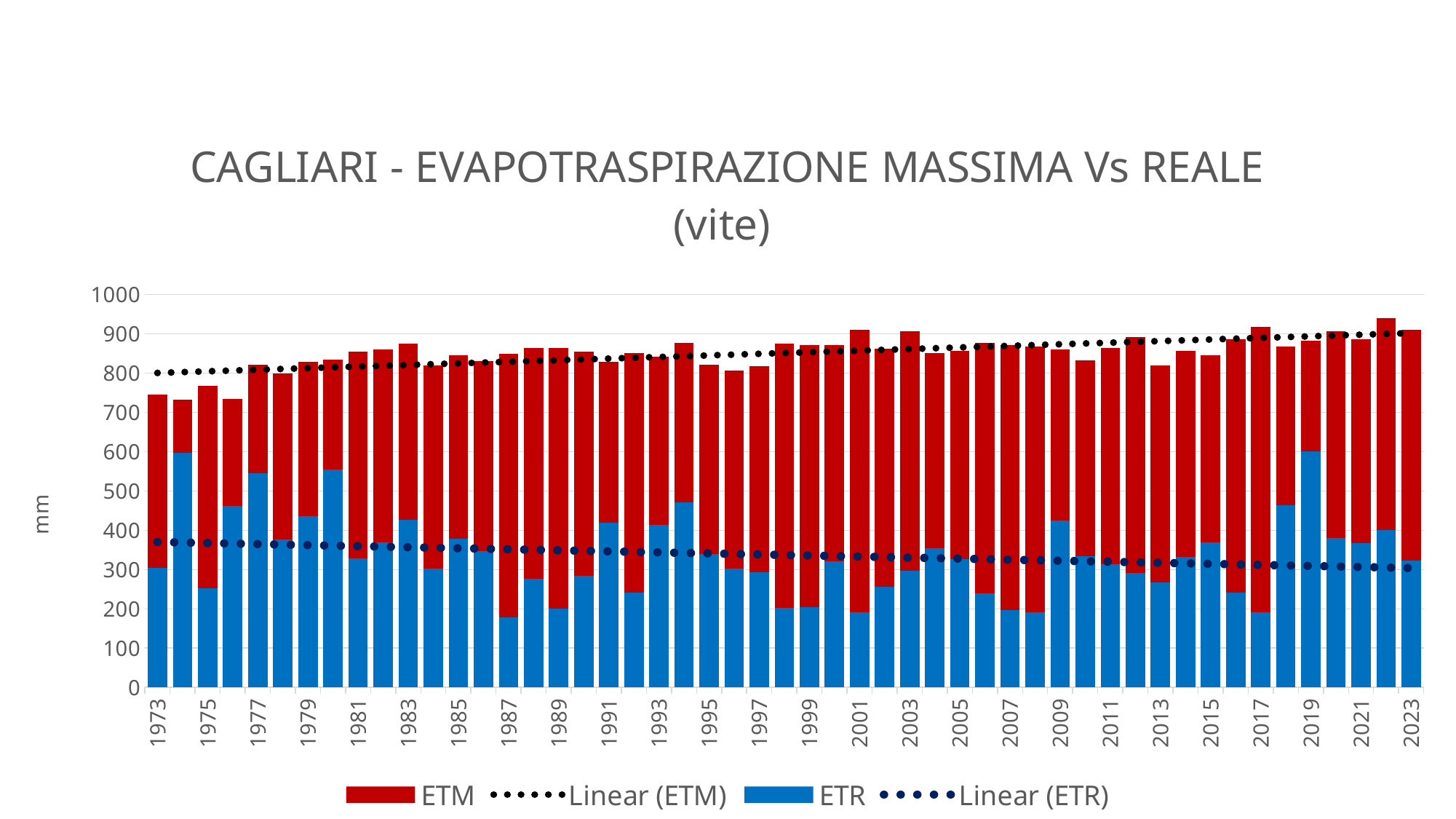
Which year has the highest ETM value? 2022 What is the title of the chart? CAGLIARI - EVAPOTRASPIRAZIONE MASSIMA Vs REALE (vite) Is the ETM value for 2022 greater or less than 900? greater What unit is shown on the vertical axis label? mm How many entries does the legend list? 4 Is the ETM value for 1973 greater or less than 800? less Does the Linear (ETR) trend line rise or fall from 1973 to 2023? fall Which is larger, the ETR value for 1977 or the ETR value for 1987? 1977 Is the ETR value for 1974 greater or less than 500? greater Does the Linear (ETM) trend line rise or fall from 1973 to 2023? rise What kind of chart is shown on the slide? bar chart